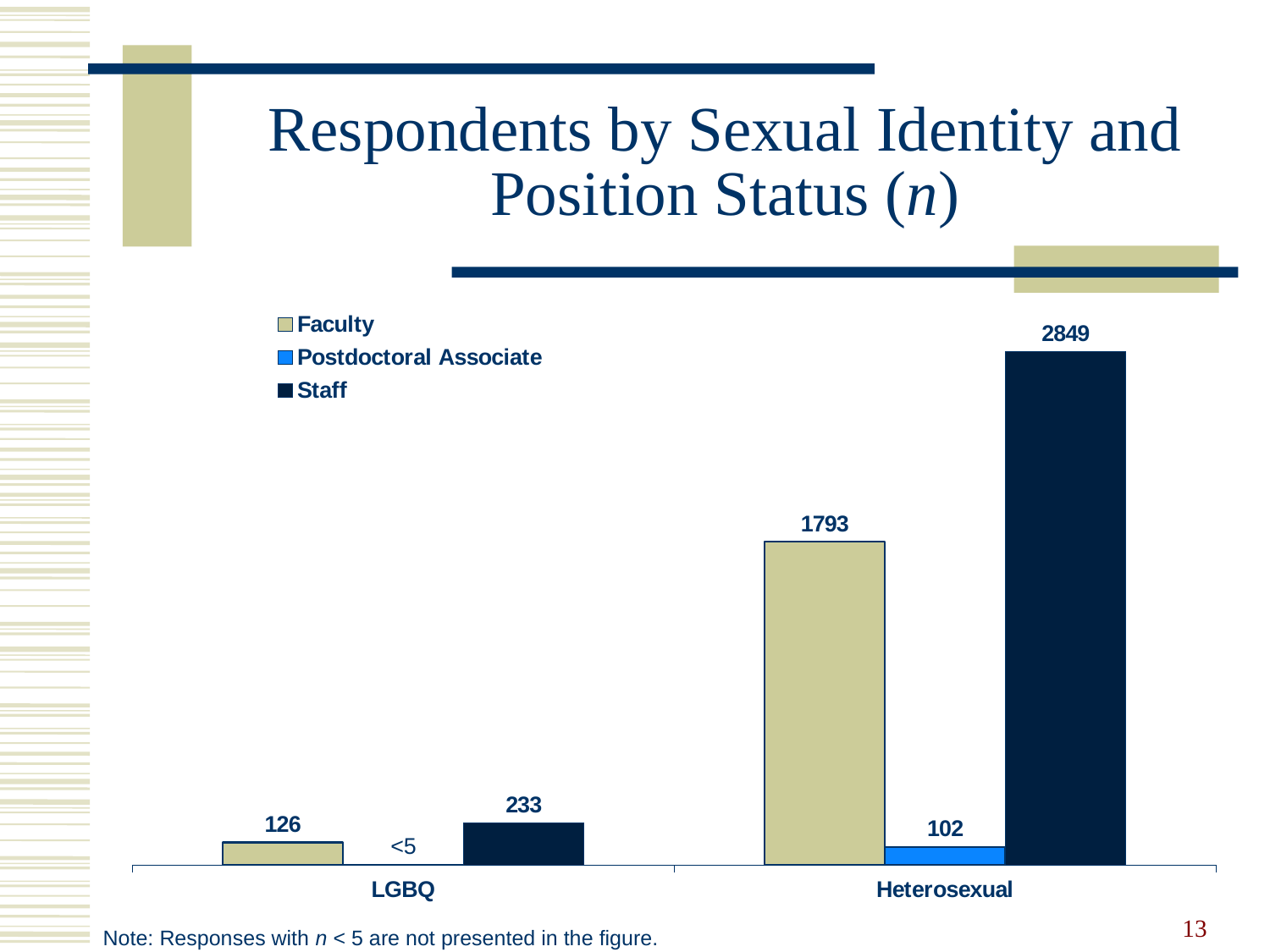
Which series has the highest value in the Heterosexual category? Staff What is the number of Staff respondents in the LGBQ category? 233 Which is larger: Faculty in the Heterosexual category or Staff in the LGBQ category? Faculty in the Heterosexual category Which series has the lowest value in the Heterosexual category? Postdoctoral Associate What is the difference between the Staff and Faculty values in the LGBQ category? 107 What is the difference between the Staff and Faculty values in the Heterosexual category? 1056 What is the number of Faculty respondents in the LGBQ category? 126 What kind of chart is shown on the slide? Bar chart What is the number of Staff respondents in the Heterosexual category? 2849 What label is shown for the Postdoctoral Associate value in the LGBQ category? <5 What is the number of Postdoctoral Associate respondents in the Heterosexual category? 102 How many series does the legend list? 3